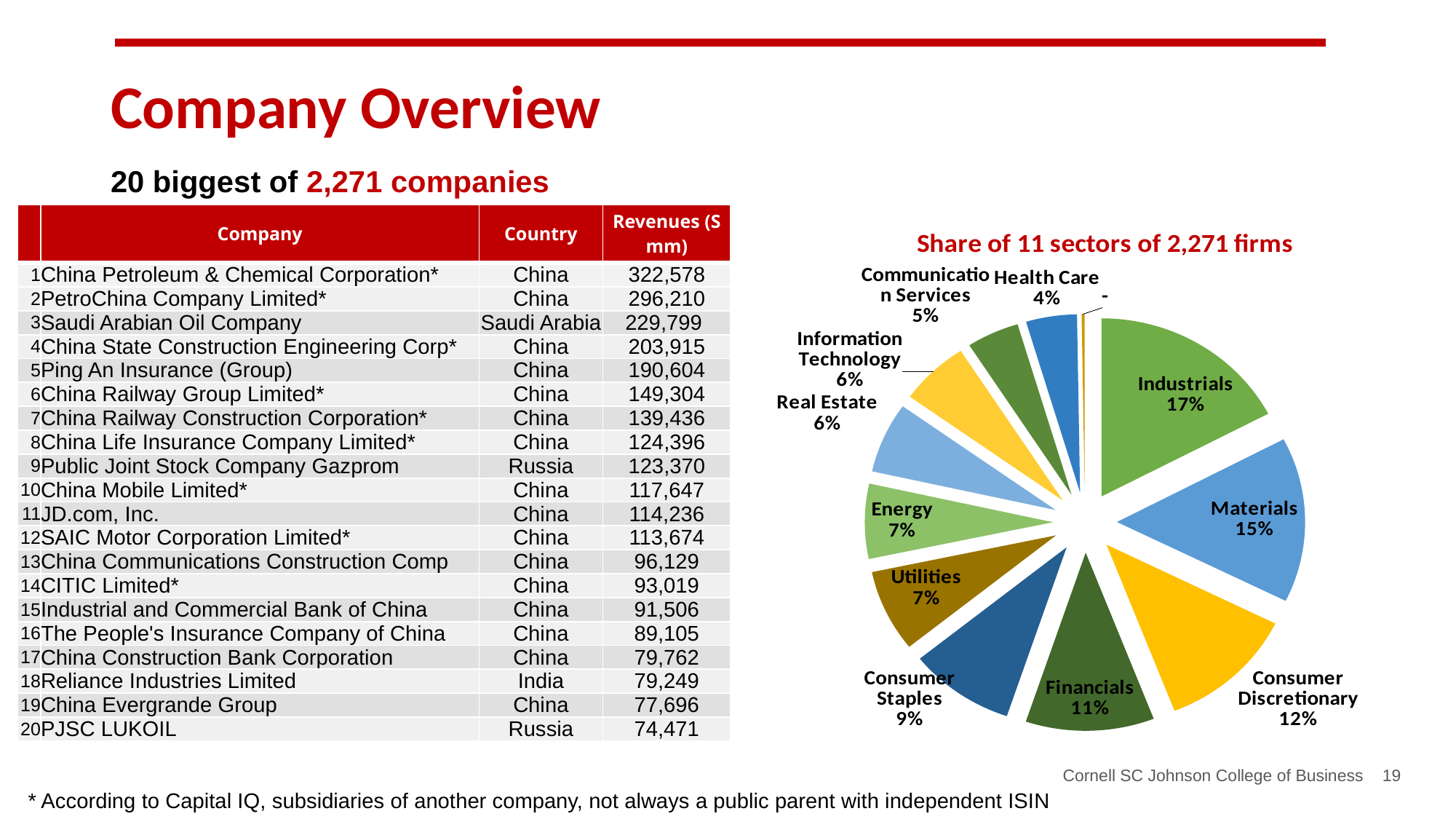
In the pie chart, what share does Communication Services have? 5% In the pie chart, what share do Materials have? 15% In the pie chart, what share do Financials have? 11% In the pie chart, what share does Consumer Staples have? 9% Among the sectors with a percentage label in the pie chart, which has the smallest share? Health Care What kind of chart is shown on the right side of the slide? pie chart In the pie chart, what share does Real Estate have? 6% Which sector has the largest share in the pie chart? Industrials In the pie chart, what share do Industrials have? 17% What is the title of the pie chart? Share of 11 sectors of 2,271 firms In the pie chart, which has the larger share: Consumer Discretionary or Financials? Consumer Discretionary In the pie chart, how many percentage points larger is the Industrials share than the Materials share? 2 percentage points